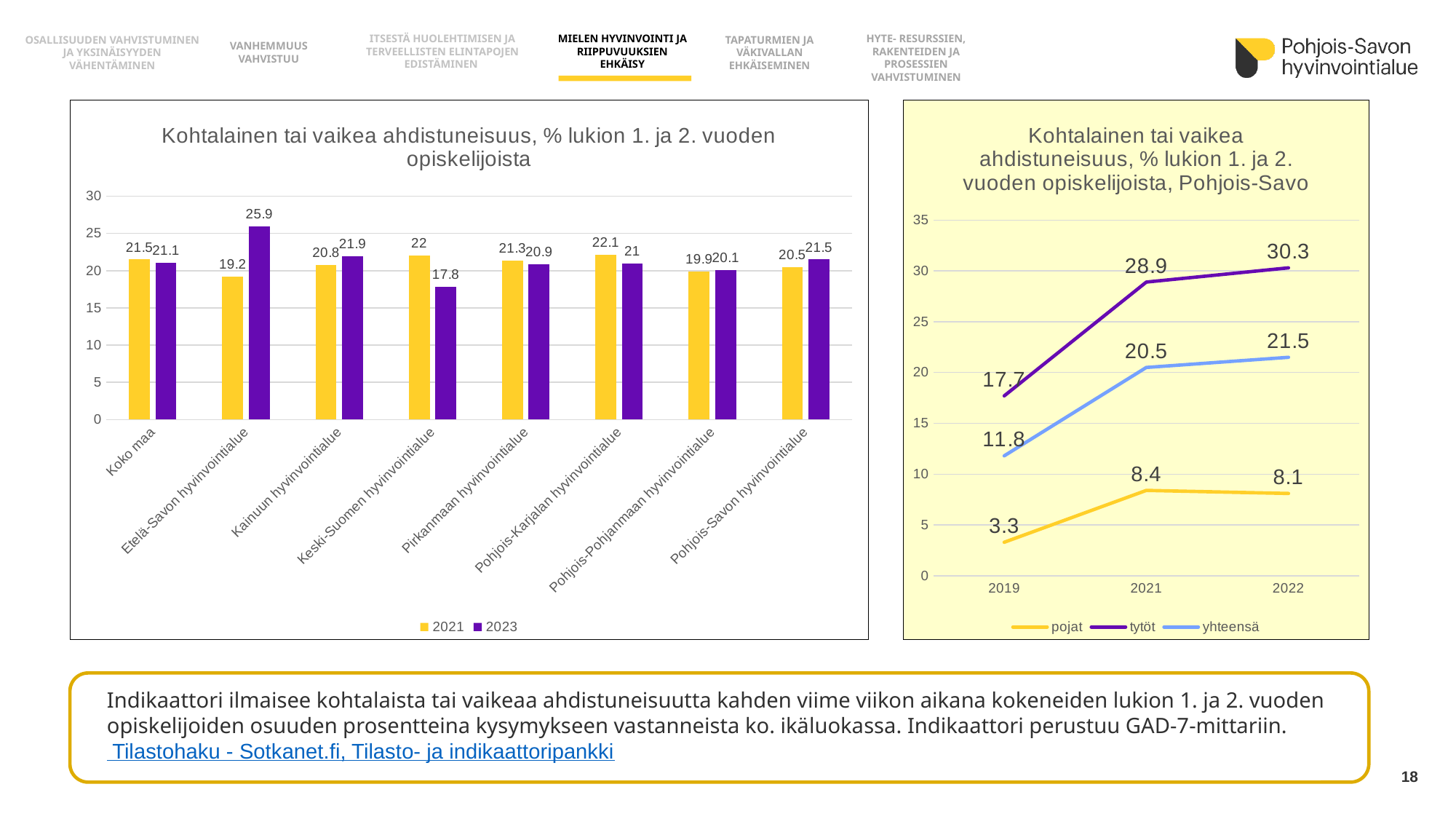
What type of chart is the chart on the left? Bar chart In the left bar chart, what is the 2023 value for Etelä-Savon hyvinvointialue? 25.9 In the right line chart, does the yhteensä line rise or fall from 2019 to 2022? Rises In the right line chart, what is the value for tytöt in 2022? 30.3 In the left bar chart, how many regions (categories) are shown? 8 In the left bar chart, what is the difference between the 2023 and 2021 values for Etelä-Savon hyvinvointialue? 6.7 In the left bar chart, what is the 2021 value for Keski-Suomen hyvinvointialue? 22 In the right line chart, what is the difference between the tytöt and pojat values in 2021? 20.5 In the left bar chart, which region has the lowest 2023 value? Keski-Suomen hyvinvointialue In the left bar chart, which region has the highest 2023 value? Etelä-Savon hyvinvointialue In the right line chart, what is the value for pojat in 2019? 3.3 In the right line chart, how many series does the legend list? 3